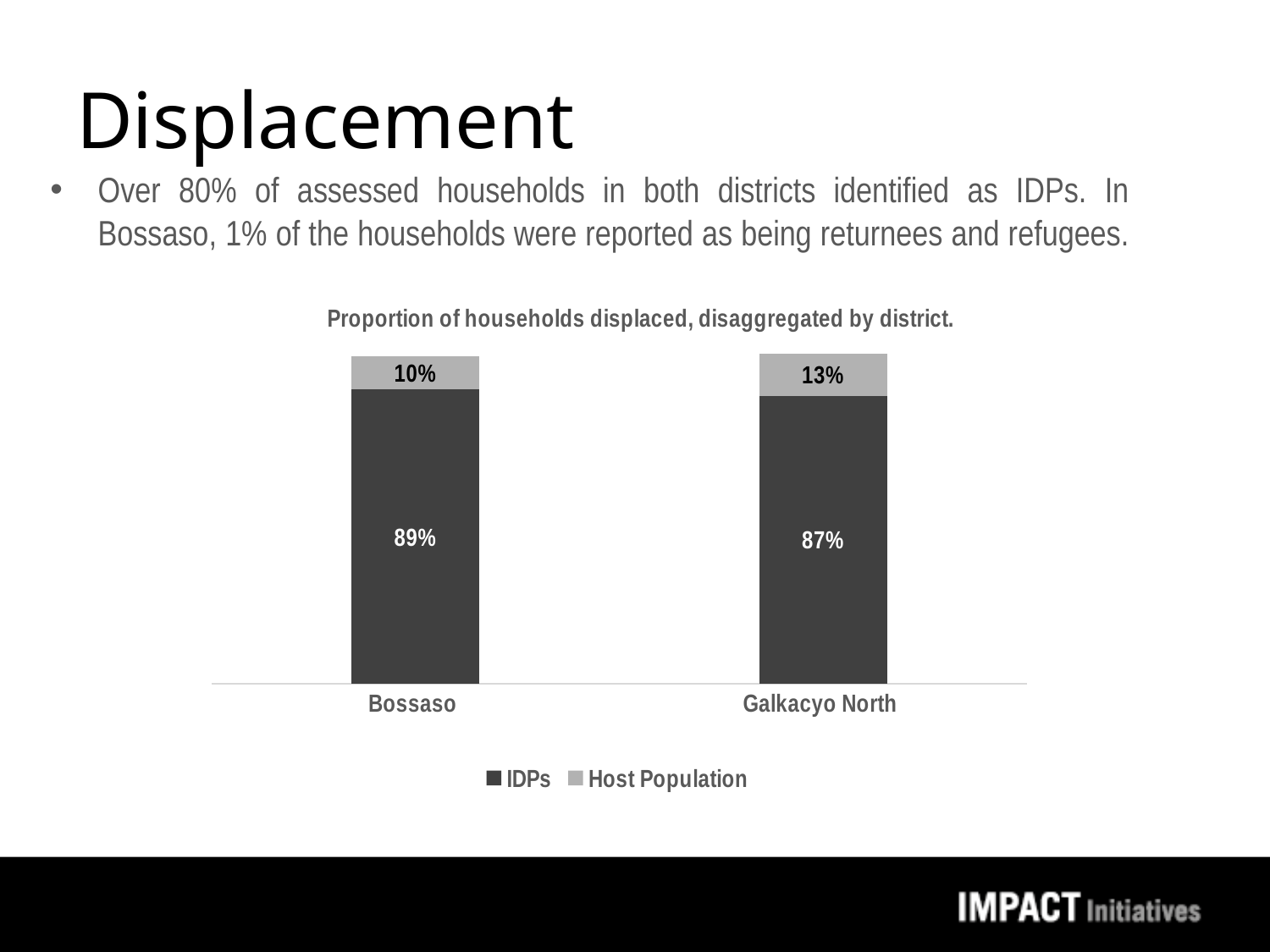
How many districts are shown on the x axis? 2 What is the difference between the IDPs share in Bossaso and in Galkacyo North? 2% What percentage of households in Bossaso are IDPs? 89% What percentage of households in Bossaso are Host Population? 10% Which district has the lower proportion of Host Population? Bossaso What is the title of the chart? Proportion of households displaced, disaggregated by district. How many series does the legend list? 2 Is the Host Population share larger in Bossaso or in Galkacyo North? Galkacyo North What percentage of households in Galkacyo North are IDPs? 87% Which district has the higher proportion of IDPs? Bossaso What kind of chart is shown? Stacked bar chart What percentage of households in Galkacyo North are Host Population? 13%